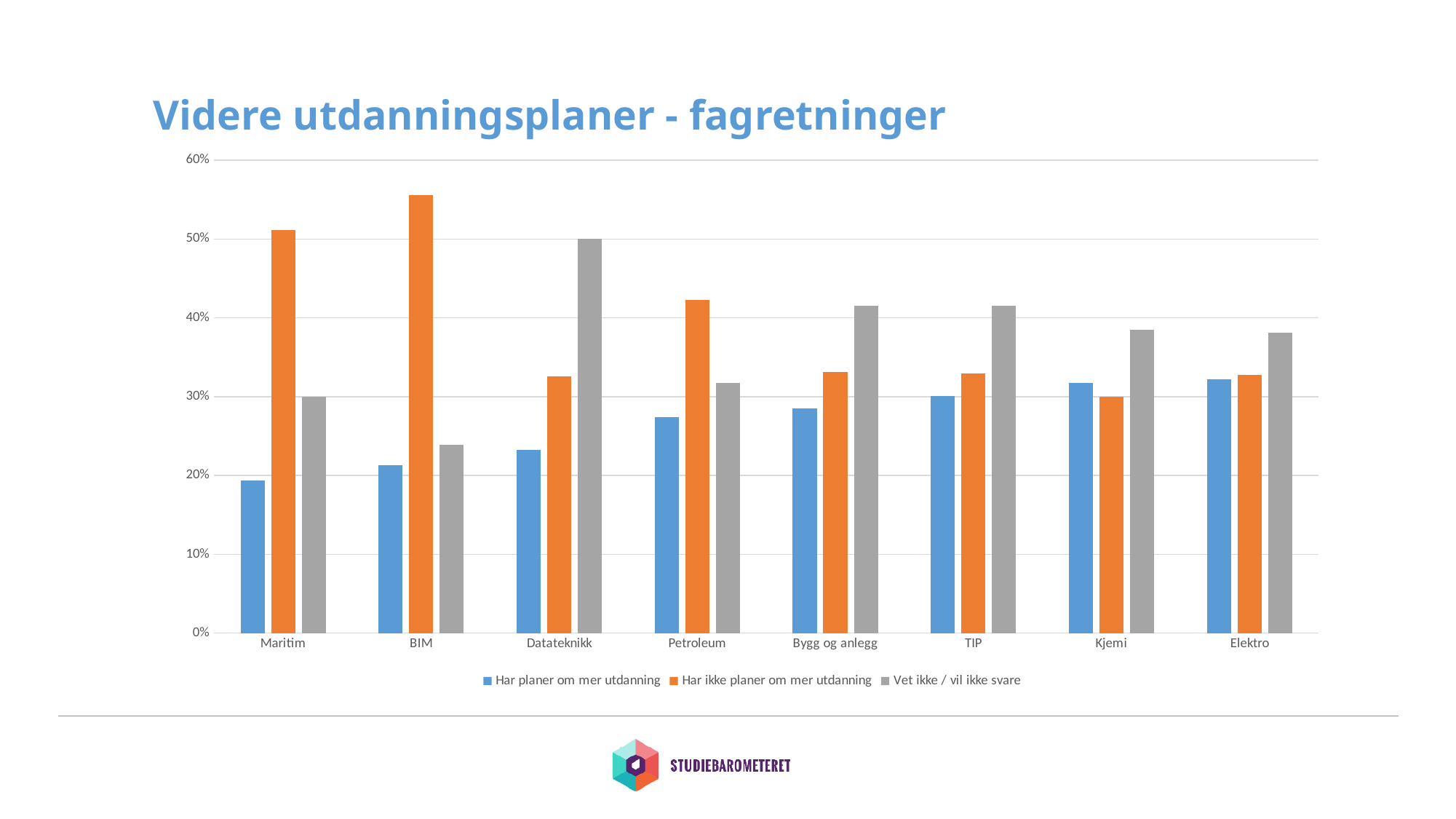
For Petroleum, which is larger: 'Har ikke planer om mer utdanning' or 'Vet ikke / vil ikke svare'? Har ikke planer om mer utdanning Is the value for 'Har ikke planer om mer utdanning' for Maritim greater or less than 40%? greater How many fagretninger (categories) are shown on the x axis? 8 Is the value for 'Har planer om mer utdanning' for BIM greater or less than 30%? less How many series does the legend list? 3 Which category has the highest value for 'Har ikke planer om mer utdanning'? BIM What is the title of the chart? Videre utdanningsplaner - fagretninger Is the value for 'Vet ikke / vil ikke svare' for Datateknikk greater or less than 40%? greater Does the 'Har planer om mer utdanning' series rise or fall from Maritim to Elektro along the x axis? rises What kind of chart is shown on the slide? Bar chart Which category has the lowest value for 'Har planer om mer utdanning'? Maritim Which category has the highest value for 'Vet ikke / vil ikke svare'? Datateknikk